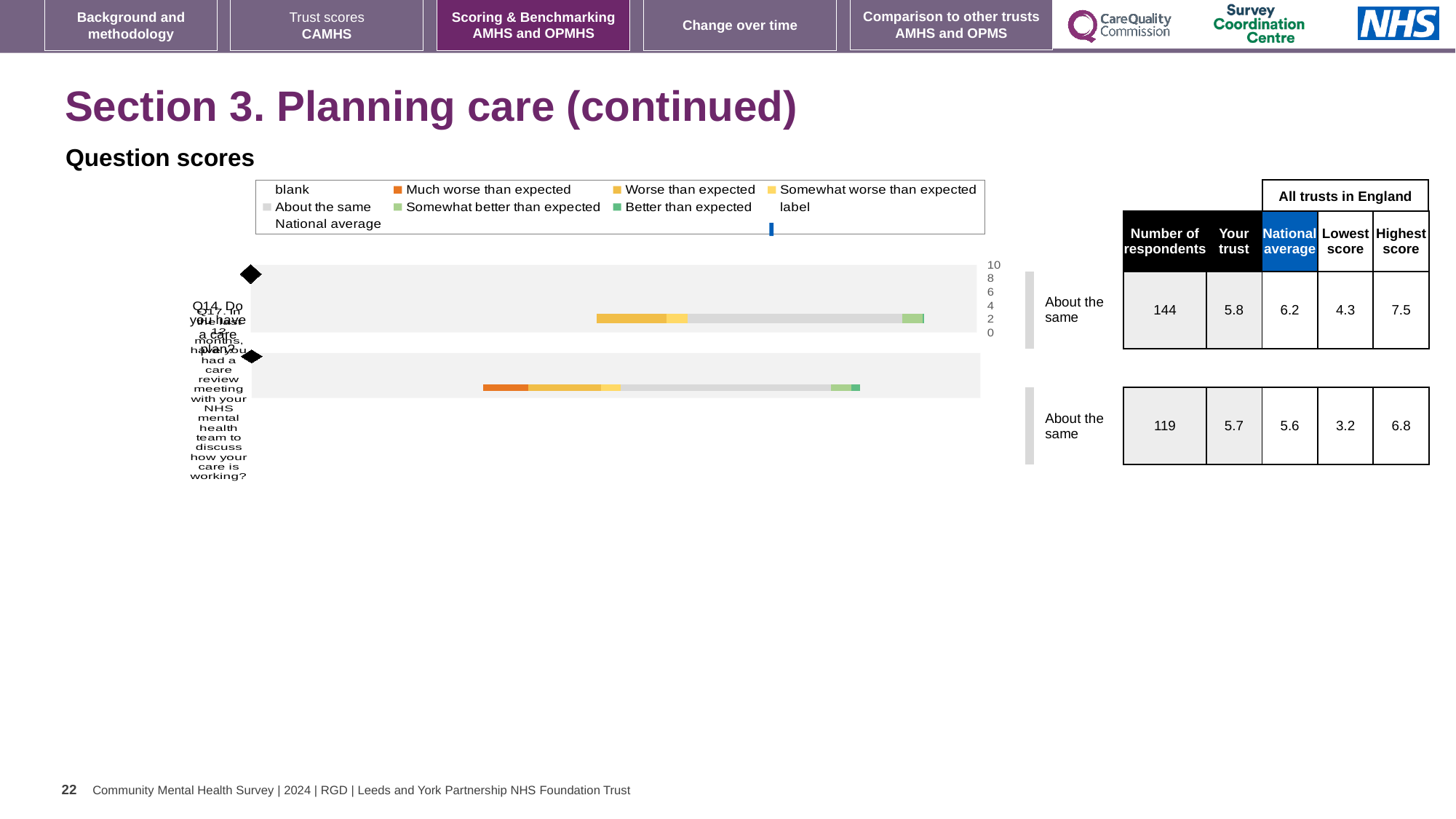
Which colour does the legend use for "Much worse than expected"? orange What kind of chart is shown under "Question scores"? bar chart What benchmark category is shown next to both bars? About the same What is the number of respondents shown for the first row (Q14) in the table? 144 What is the difference between the highest score and the lowest score for the first row (Q14)? 3.2 What is the highest score among all trusts in England for the first row (Q14)? 7.5 How many question bars are plotted in the chart? 2 Which colour does the legend use for "Better than expected"? green What is the "Your trust" score for the first row (Q14)? 5.8 What is the number of respondents shown for the second row (Q17) in the table? 119 For the first row (Q14), which is larger: the "Your trust" score or the national average? National average What is the national average for the second row (Q17)? 5.6